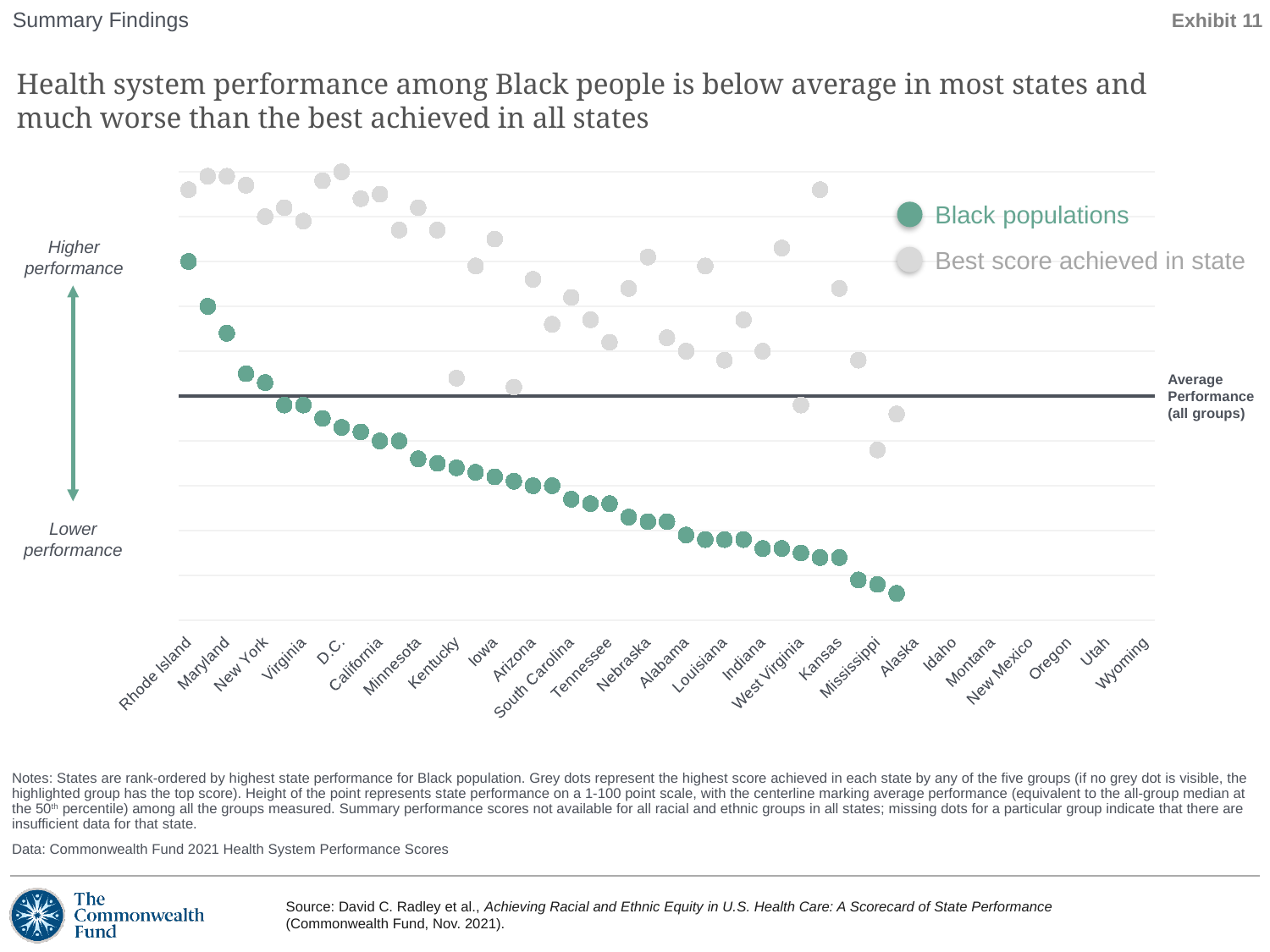
Among the labelled states with a Black populations dot, which has the lowest score? Mississippi How many series does the legend list? 2 Do the Black populations scores rise or fall from left to right along the x axis? Fall Which has the higher Black populations score, Kentucky or Nebraska? Kentucky Among the labelled states, which has the highest Black populations score? Rhode Island What colour are the dots for Black populations? Green What are the two series named in the legend? Black populations; Best score achieved in state Which has the higher Black populations score, Rhode Island or Maryland? Rhode Island How many state names are labelled on the x axis? 26 What kind of chart is shown on the slide? Dot plot (scatter chart) Is the Black populations dot for Alabama above or below the Average Performance (all groups) line? Below Is the Black populations dot for Rhode Island above or below the Average Performance (all groups) line? Above